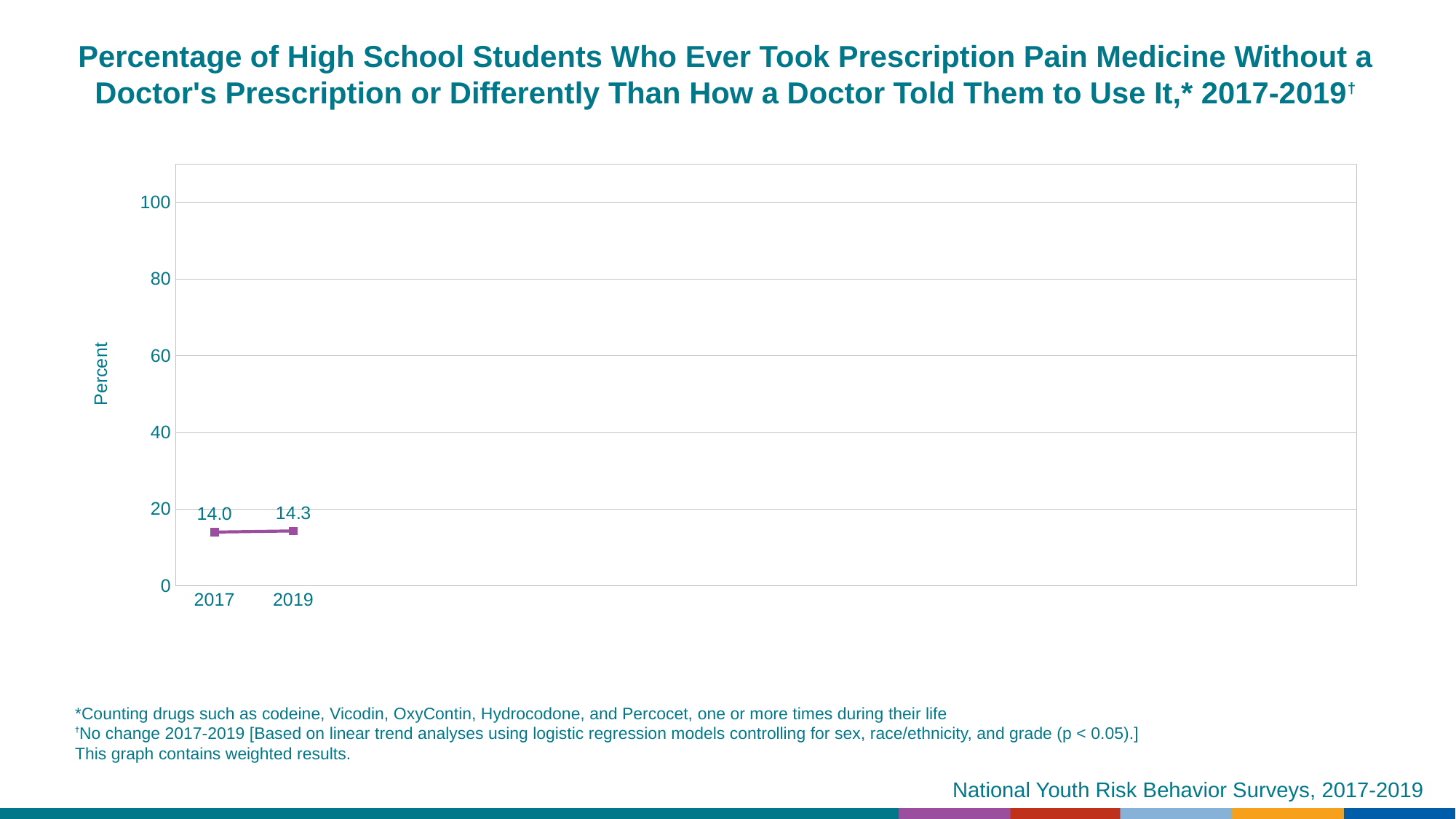
What is the difference between the 2019 value and the 2017 value? 0.3 Do the values rise or fall from 2017 to 2019? rise What kind of chart is shown on the slide? Line chart Is the value for 2019 greater or less than 20? less Is the value for 2017 greater or less than 40? less What is the label on the y axis? Percent What is the value for 2017? 14.0 Which year has the higher value, 2017 or 2019? 2019 What is the value for 2019? 14.3 How many data points are plotted on the chart? 2 What is the highest tick value shown on the y axis? 100